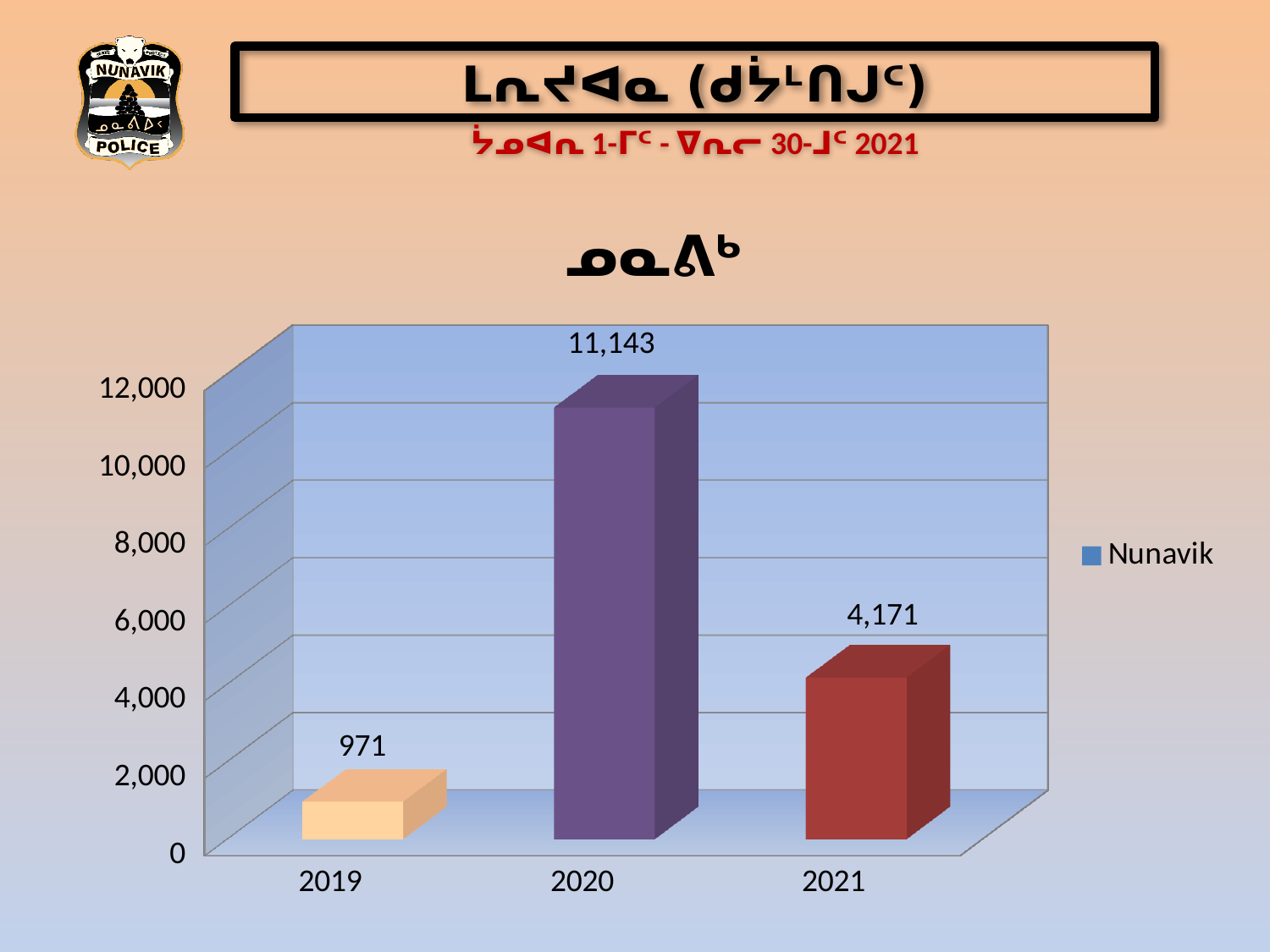
What is the value for 2019? 971 What is the difference between the values for 2021 and 2019? 3,200 Is the value for 2021 greater or less than 6,000? less Which year has the highest value? 2020 What is the difference between the values for 2020 and 2021? 6,972 How many years are shown on the x axis? 3 How many series does the legend list? 1 What is the value for 2021? 4,171 What kind of chart is shown? bar chart What is the value for 2020? 11,143 Which year has the lowest value? 2019 Which is larger, the value for 2021 or the value for 2019? 2021